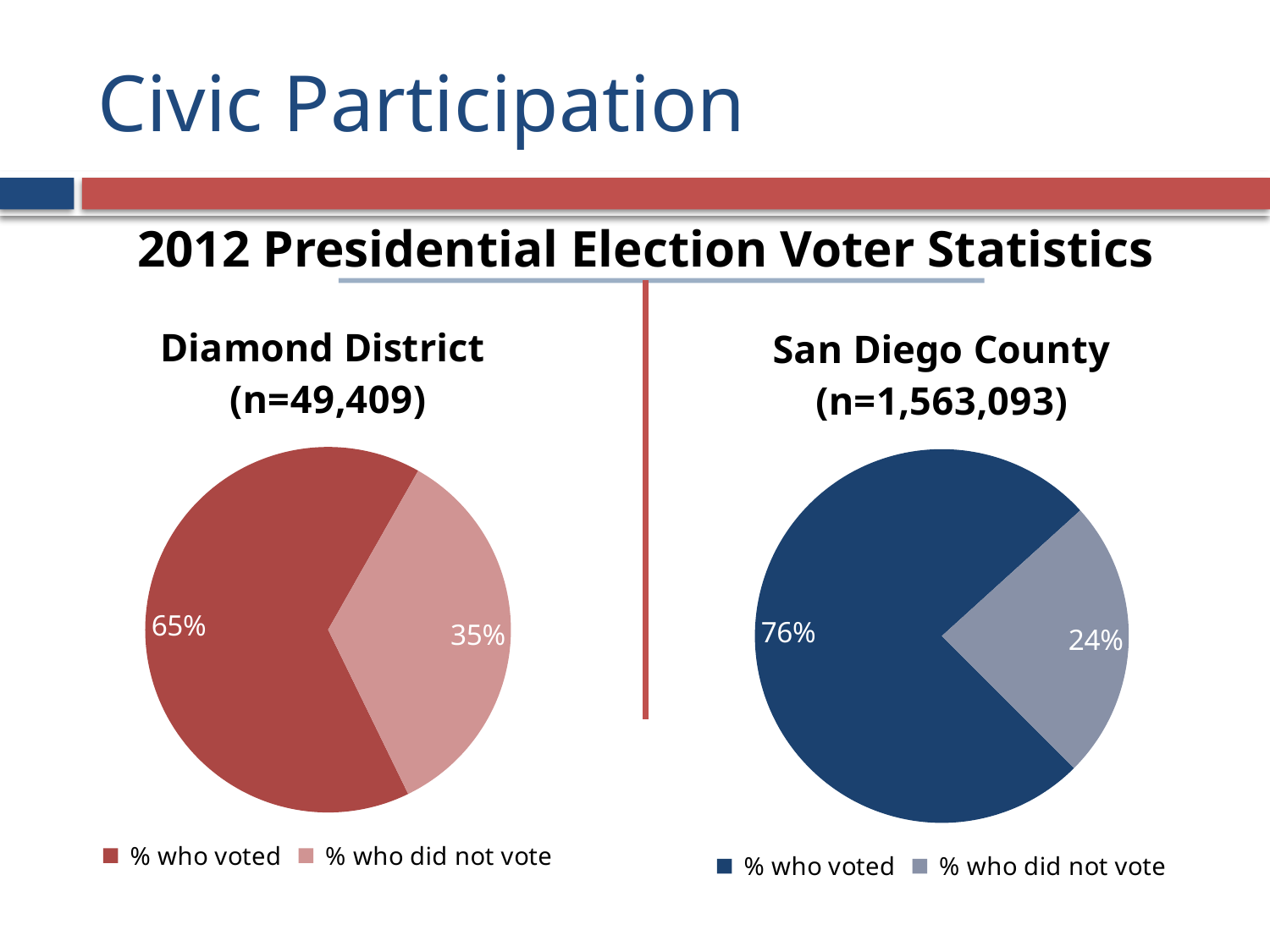
What is the difference between the percentage who voted in San Diego County and the percentage who voted in the Diamond District? 11% In the Diamond District pie chart, what percentage voted? 65% What is the sample size (n) shown for the San Diego County chart? 1,563,093 In the San Diego County pie chart, which slice is the smallest? % who did not vote What type of chart is used for the Diamond District data? Pie chart In the San Diego County pie chart, what percentage voted? 76% In the Diamond District pie chart, which slice is the largest? % who voted How many entries does the legend of the Diamond District chart list? 2 In the San Diego County pie chart, what percentage did not vote? 24% In the Diamond District pie chart, what percentage did not vote? 35% How many slices does the San Diego County pie chart have? 2 Which is larger: the percentage who did not vote in the Diamond District or in San Diego County? Diamond District